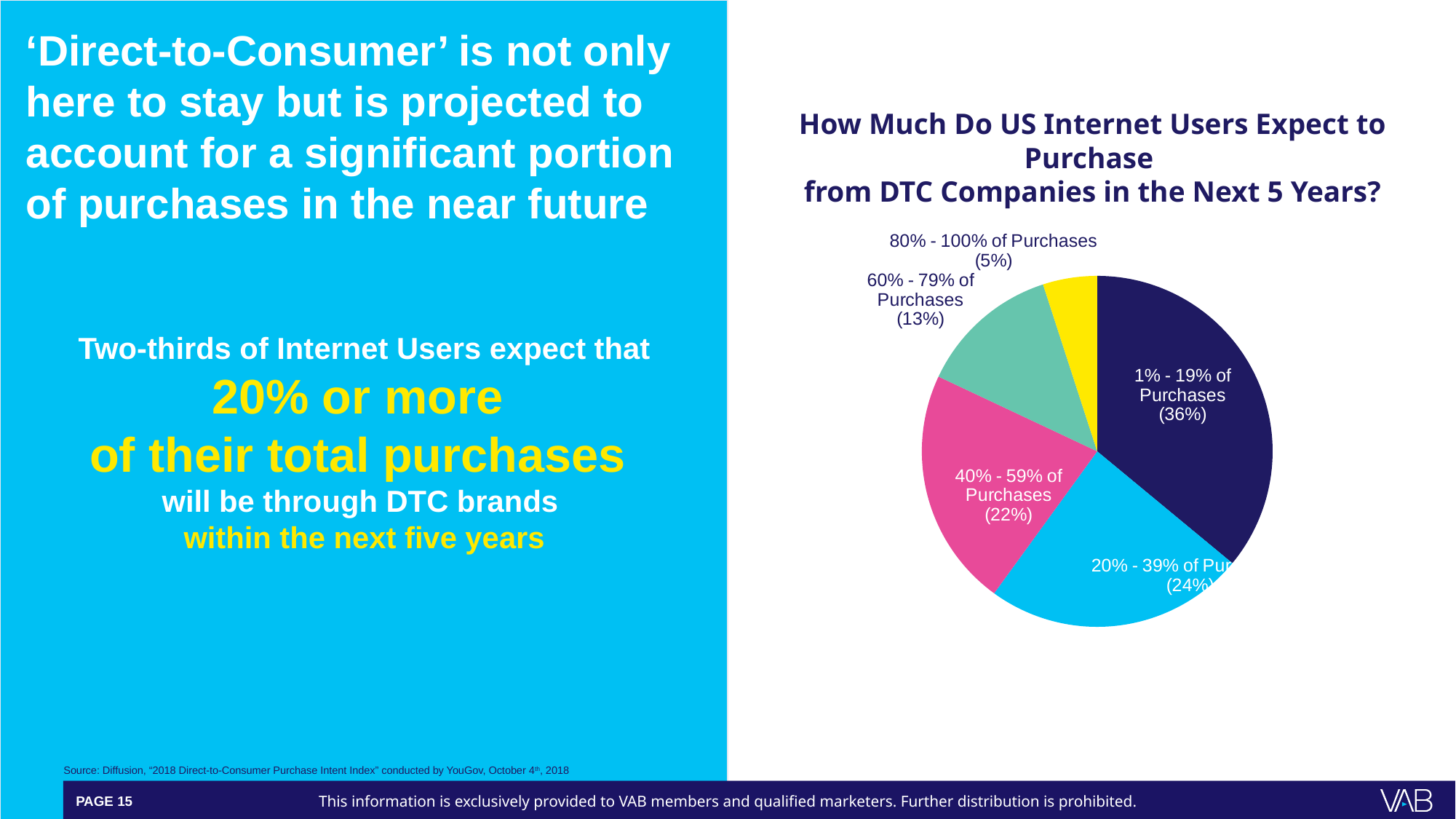
What share of US internet users expect 60% - 79% of purchases from DTC companies? 13% What kind of chart is shown on the slide? Pie chart What share of US internet users expect 1% - 19% of purchases from DTC companies in the next 5 years? 36% Which is larger: the share for 60% - 79% of purchases or the share for 80% - 100% of purchases? 60% - 79% of Purchases Which purchase range has the smallest slice of the pie? 80% - 100% of Purchases What is the title of the pie chart? How Much Do US Internet Users Expect to Purchase from DTC Companies in the Next 5 Years? What is the combined share of the 60% - 79% and 80% - 100% slices? 18% What share of US internet users expect 40% - 59% of purchases from DTC companies? 22% Which purchase range has the largest slice of the pie? 1% - 19% of Purchases How many slices does the pie chart have? 5 What share of US internet users expect 80% - 100% of purchases from DTC companies? 5% What is the difference in percentage points between the 1% - 19% slice and the 40% - 59% slice? 14